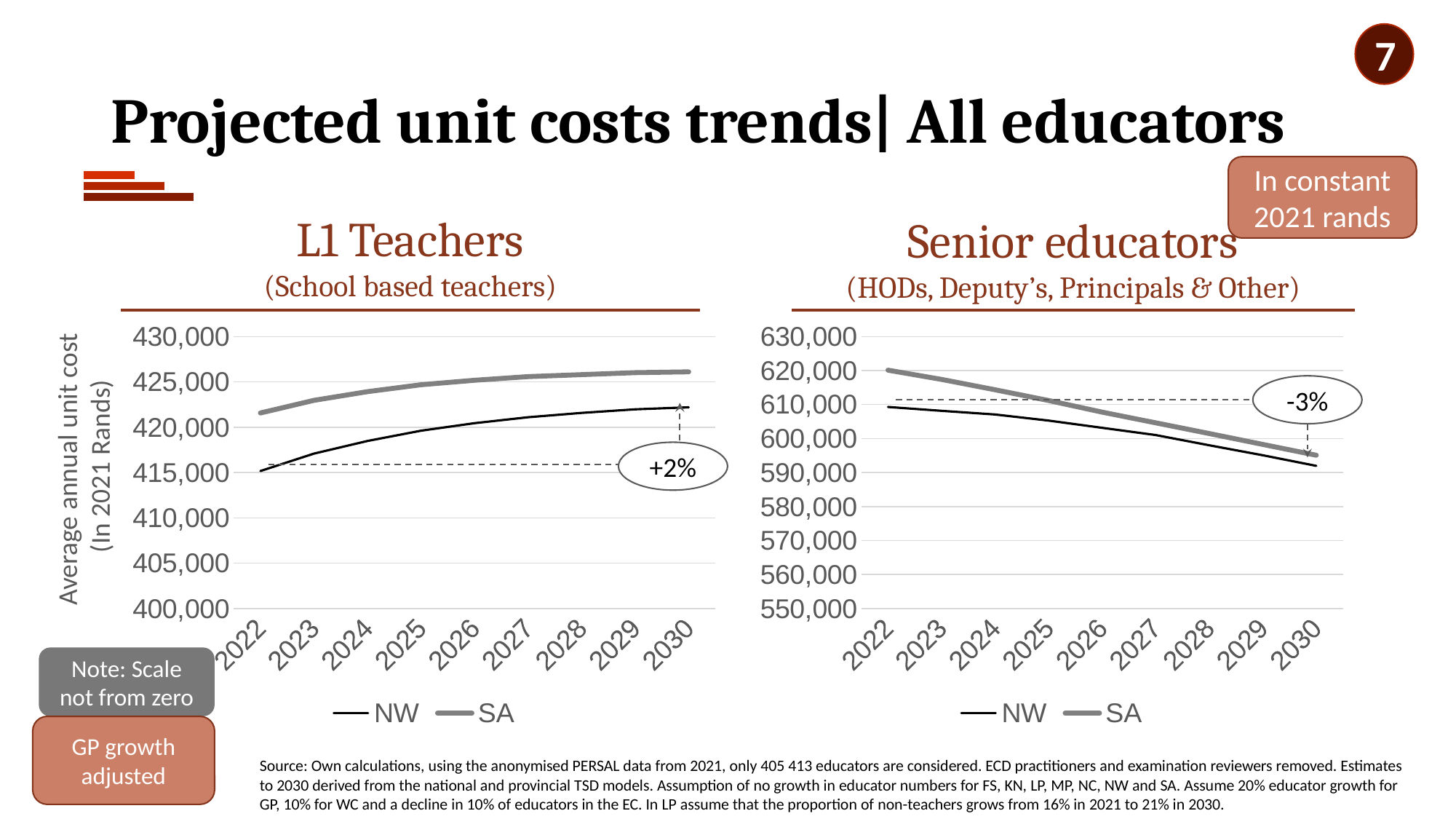
In the Senior educators chart, does the SA line rise or fall from 2022 to 2030? fall In the Senior educators chart, is the value for SA in 2022 greater or less than 610,000? greater What percentage change is annotated on the Senior educators chart? -3% In the L1 Teachers chart, does the NW line rise or fall from 2022 to 2030? rise In the L1 Teachers chart, is the value for SA in 2022 greater or less than 420,000? greater In the Senior educators chart, is the value for NW in 2030 greater or less than 600,000? less How many years are shown on the x axis of the Senior educators chart? 9 How many series does the legend of the L1 Teachers chart list? 2 What kind of chart is the L1 Teachers chart? line chart In the L1 Teachers chart, which series has the higher value in 2030, NW or SA? SA In the Senior educators chart, which series has the higher value in 2022, NW or SA? SA